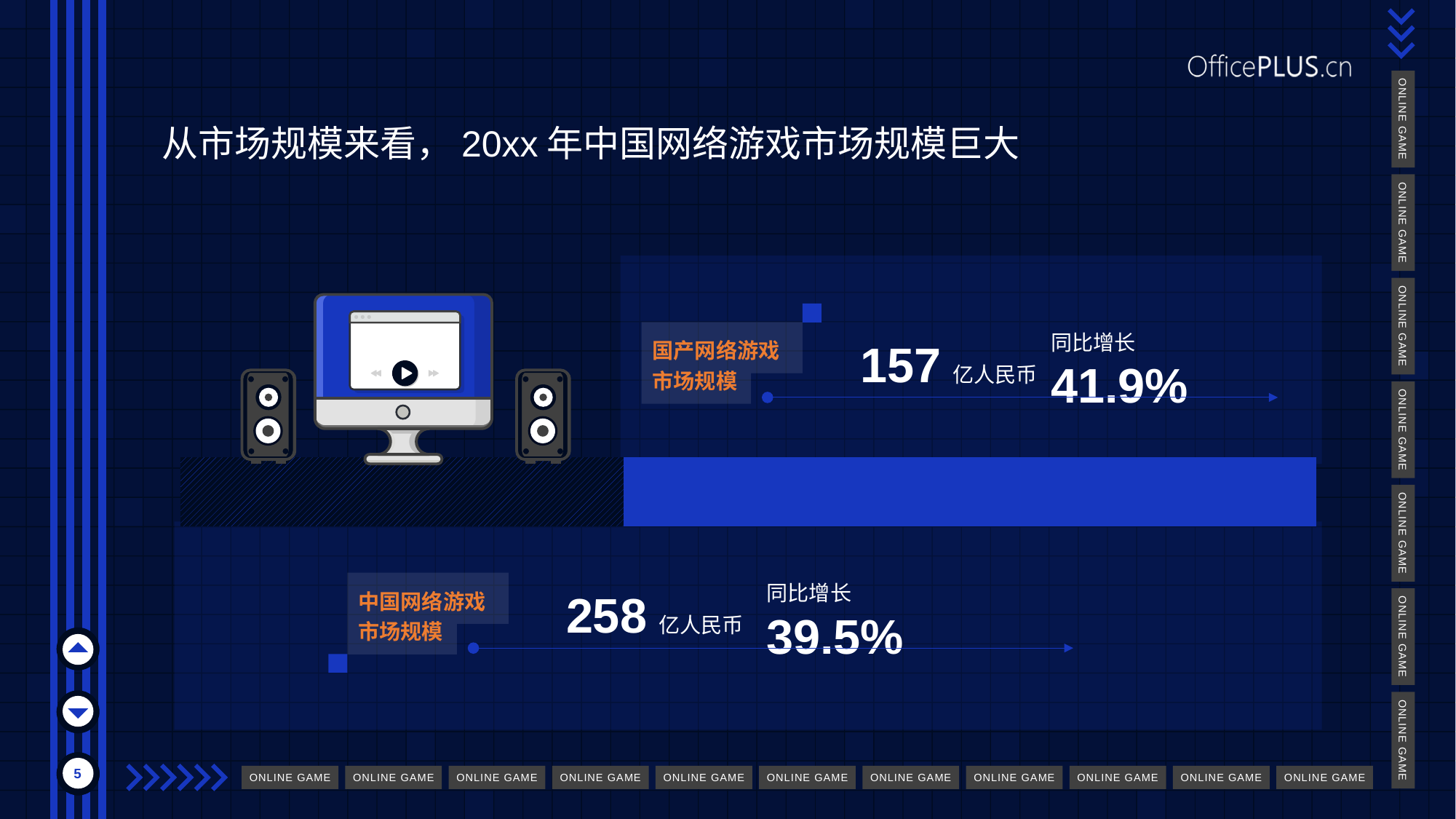
What is the difference between the 中国网络游戏市场规模 and the 国产网络游戏市场规模 values? 101 亿人民币 What is the title of the slide? 从市场规模来看， 20xx 年中国网络游戏市场规模巨大 What is the value shown for 中国网络游戏市场规模? 258 亿人民币 What is the 同比增长 (year-on-year growth) shown for 国产网络游戏市场规模? 41.9% Which has the higher 同比增长, 国产网络游戏市场规模 or 中国网络游戏市场规模? 国产网络游戏市场规模 What is the difference in 同比增长 between 国产网络游戏市场规模 and 中国网络游戏市场规模? 2.4% How many market-size figures are presented on the slide? 2 Which is larger, the market size of 国产网络游戏 or 中国网络游戏? 中国网络游戏市场规模 What is the value shown for 国产网络游戏市场规模? 157 亿人民币 What is the 同比增长 (year-on-year growth) shown for 中国网络游戏市场规模? 39.5% What unit is used for the market size values on the slide? 亿人民币